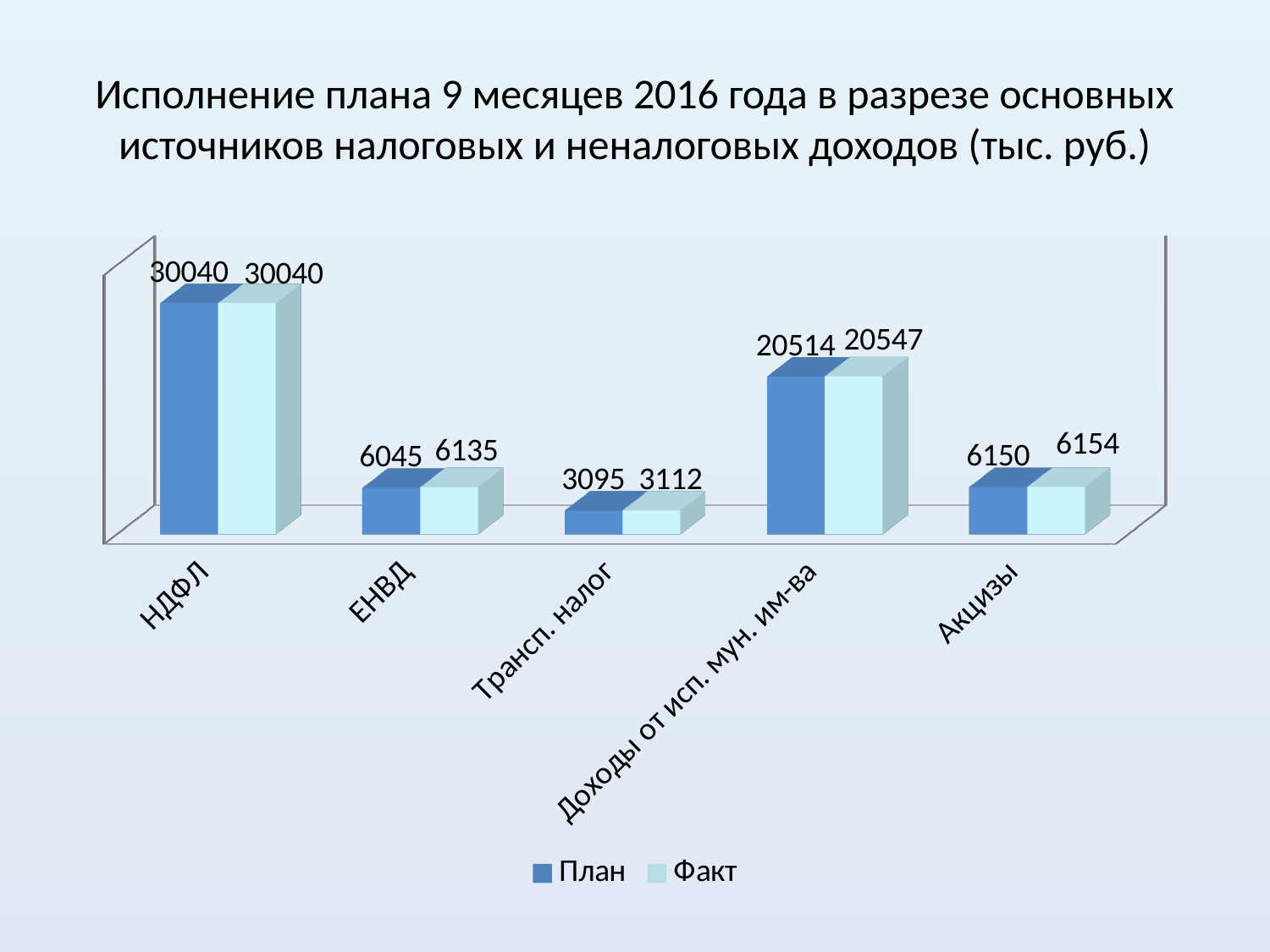
What is the difference between the Факт and План values for ЕНВД? 90 What is the Факт value for ЕНВД? 6135 What kind of chart is shown on the slide? Bar chart What is the difference between the Факт and План values for Доходы от исп. мун. им-ва? 33 What is the Факт value for Доходы от исп. мун. им-ва? 20547 What is the План value for Акцизы? 6150 How many series does the legend list? 2 Which category has the lowest План value? Трансп. налог How many categories are shown on the x axis? 5 What is the План value for Трансп. налог? 3095 Which category has the highest Факт value? НДФЛ What is the План value for НДФЛ? 30040